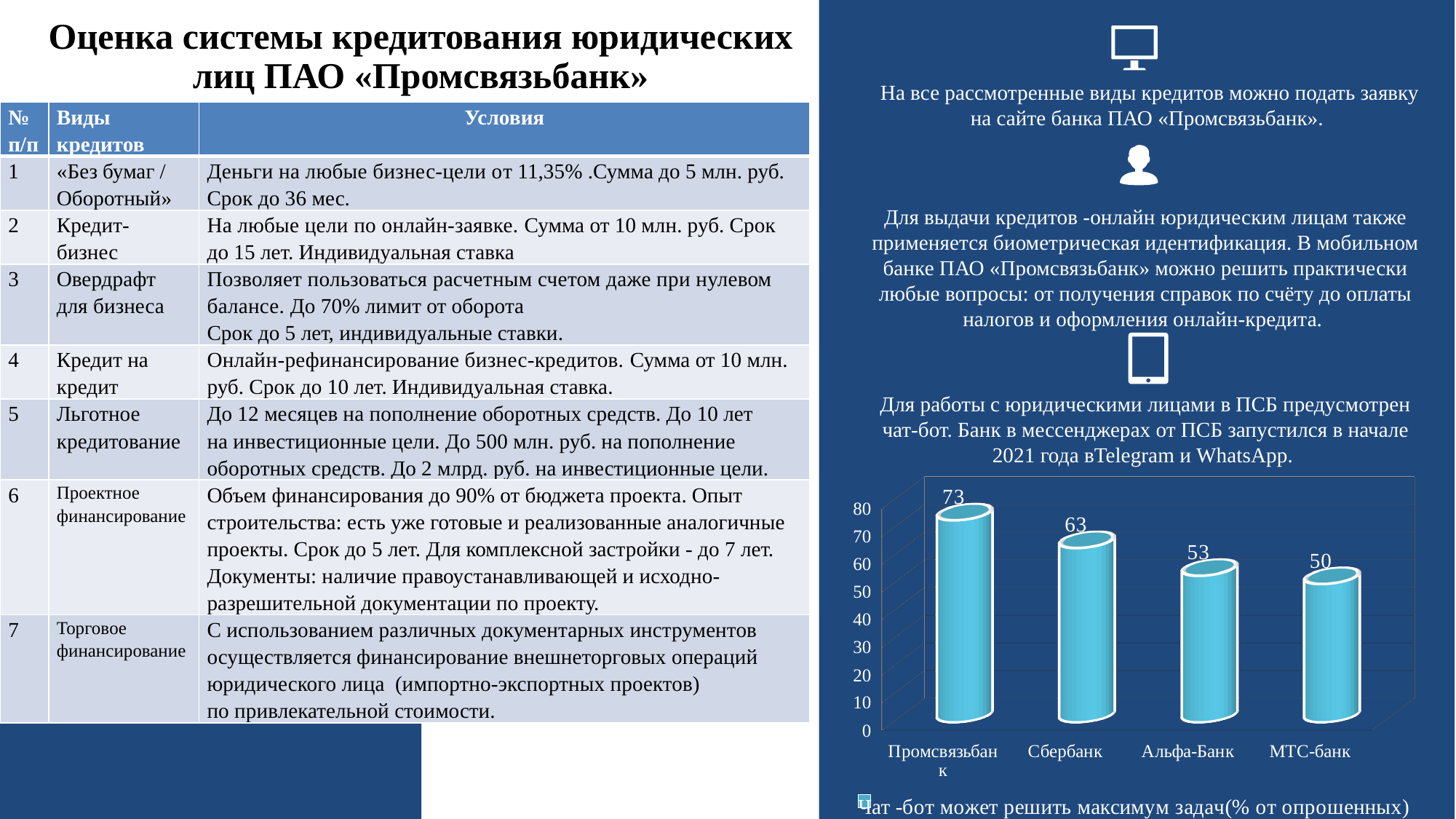
Which is larger, the value for Сбербанк or the value for Альфа-Банк? Сбербанк What is the difference between the values for Альфа-Банк and МТС-банк? 3 What value is shown for МТС-банк in the chart? 50 What is the difference between the values for Промсвязьбанк and Сбербанк? 10 What kind of chart is shown on the slide? Bar chart What value is shown for Сбербанк in the chart? 63 How many banks are shown in the chart? 4 Which bank has the lowest value in the chart? МТС-банк What value is shown for Промсвязьбанк in the chart? 73 Do the values rise or fall from left to right across the chart? Fall Which bank has the highest value in the chart? Промсвязьбанк What value is shown for Альфа-Банк in the chart? 53